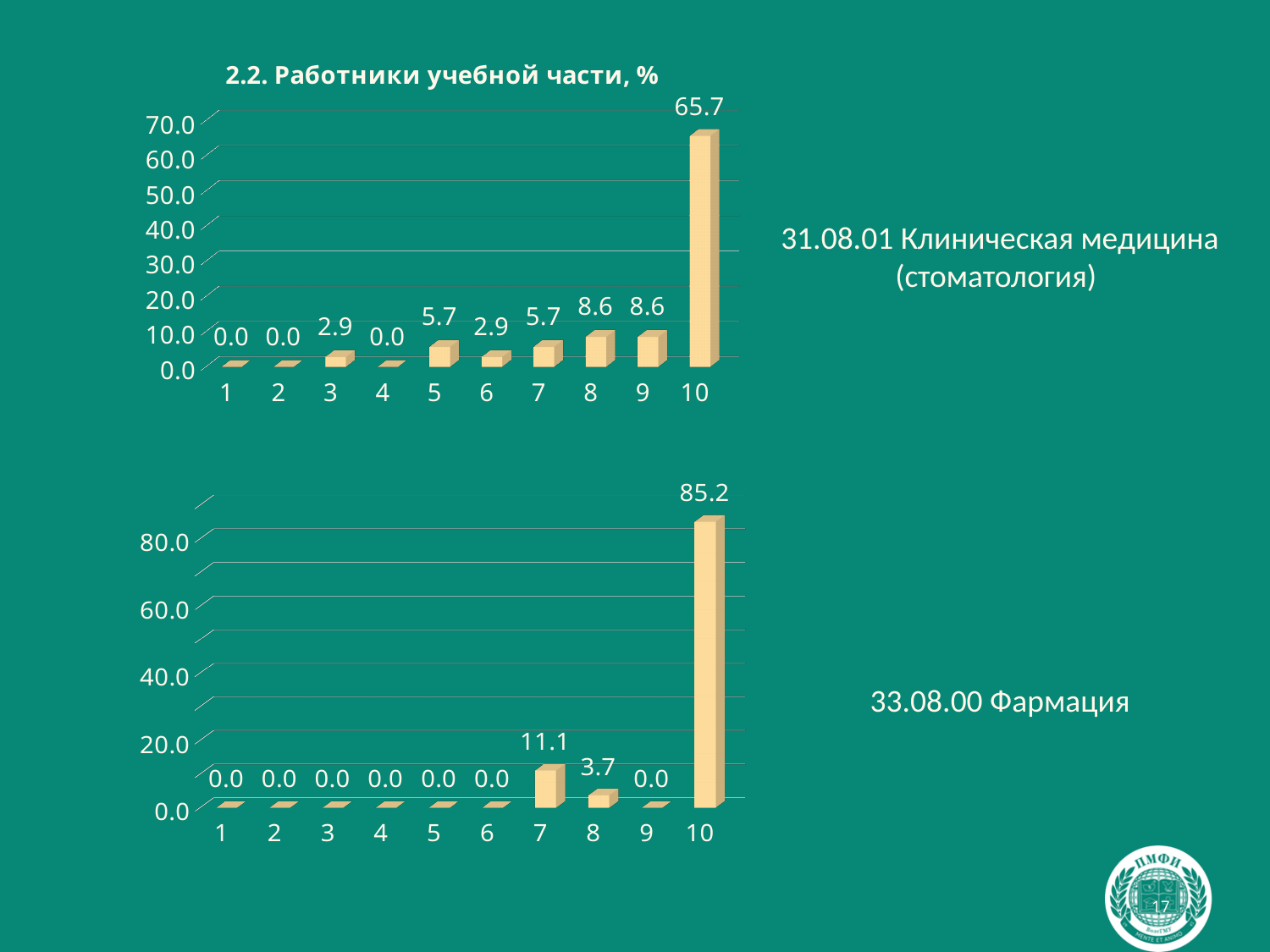
In the top chart, what is the difference between the values for category 10 and category 9? 57.1 In the top chart, what is the value for category 10? 65.7 In the top chart, how many categories are shown on the x axis? 10 In the bottom chart, what is the value for category 10? 85.2 In the bottom chart, is the value for category 10 greater or less than 80.0? greater In the bottom chart, what is the difference between the values for category 7 and category 8? 7.4 What type of chart is the bottom chart? bar chart What is the title of the top chart? 2.2. Работники учебной части, % In the bottom chart, what is the value for category 7? 11.1 In the top chart, which is larger, the value for category 5 or the value for category 6? category 5 In the top chart, what is the value for category 8? 8.6 In the top chart, which category has the highest value? 10